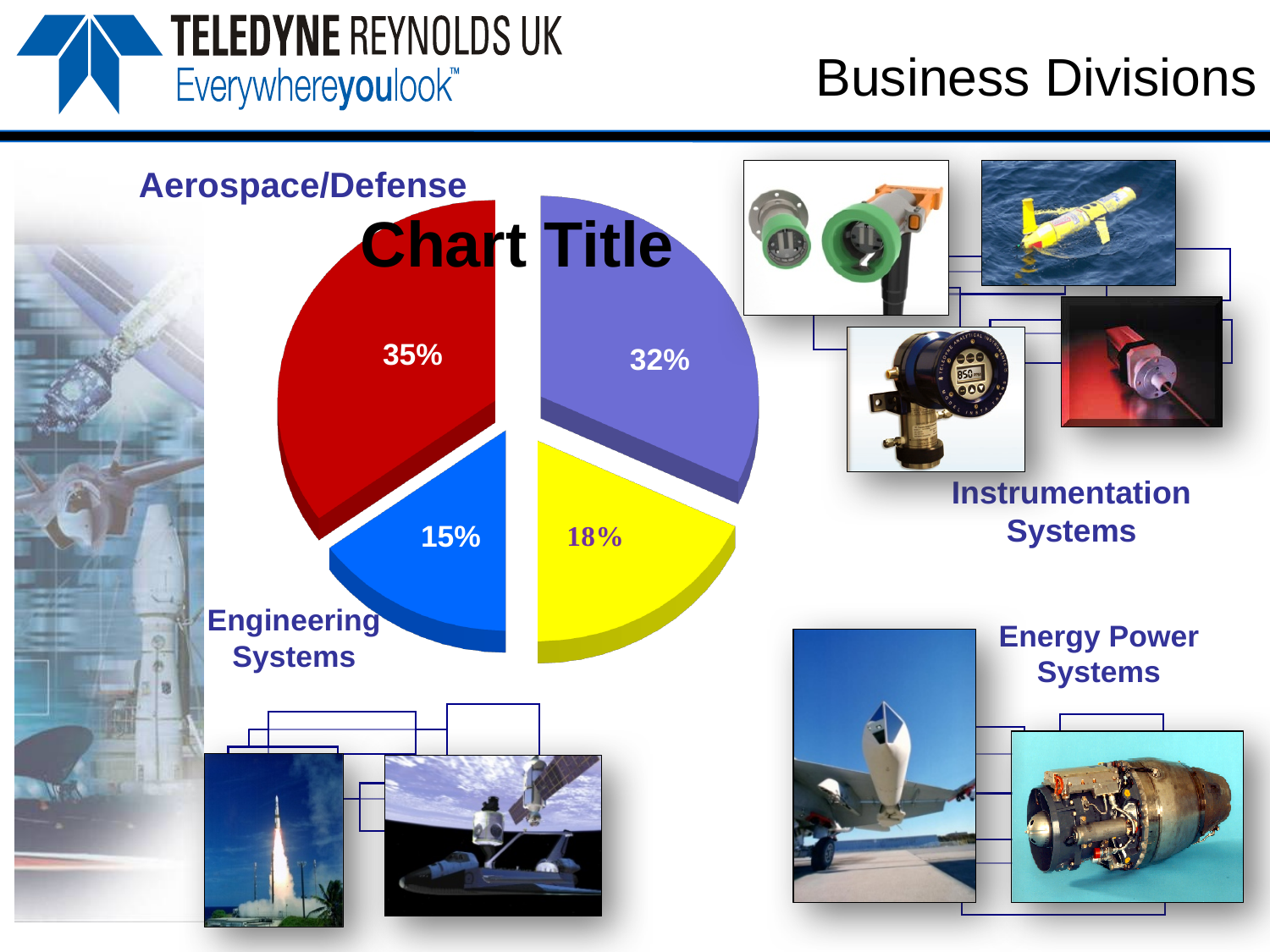
What kind of chart is shown on the slide? pie chart What share of the pie is labelled for Instrumentation Systems? 32% What percentage is shown on the red slice of the pie chart? 35% Which is larger, the yellow slice or the blue slice of the pie chart? the yellow slice (18%) Which slice of the pie chart has the smallest percentage? 15% (Engineering Systems) What percentage is shown on the blue slice of the pie chart? 15% What is the title printed on the pie chart? Chart Title How many slices does the pie chart have? 4 What is the difference in percentage points between the red slice (35%) and the purple slice (32%)? 3 What colour is the slice labelled 32% in the pie chart? purple What percentage is shown on the yellow slice of the pie chart? 18% Which slice of the pie chart has the largest percentage? 35% (Aerospace/Defense)